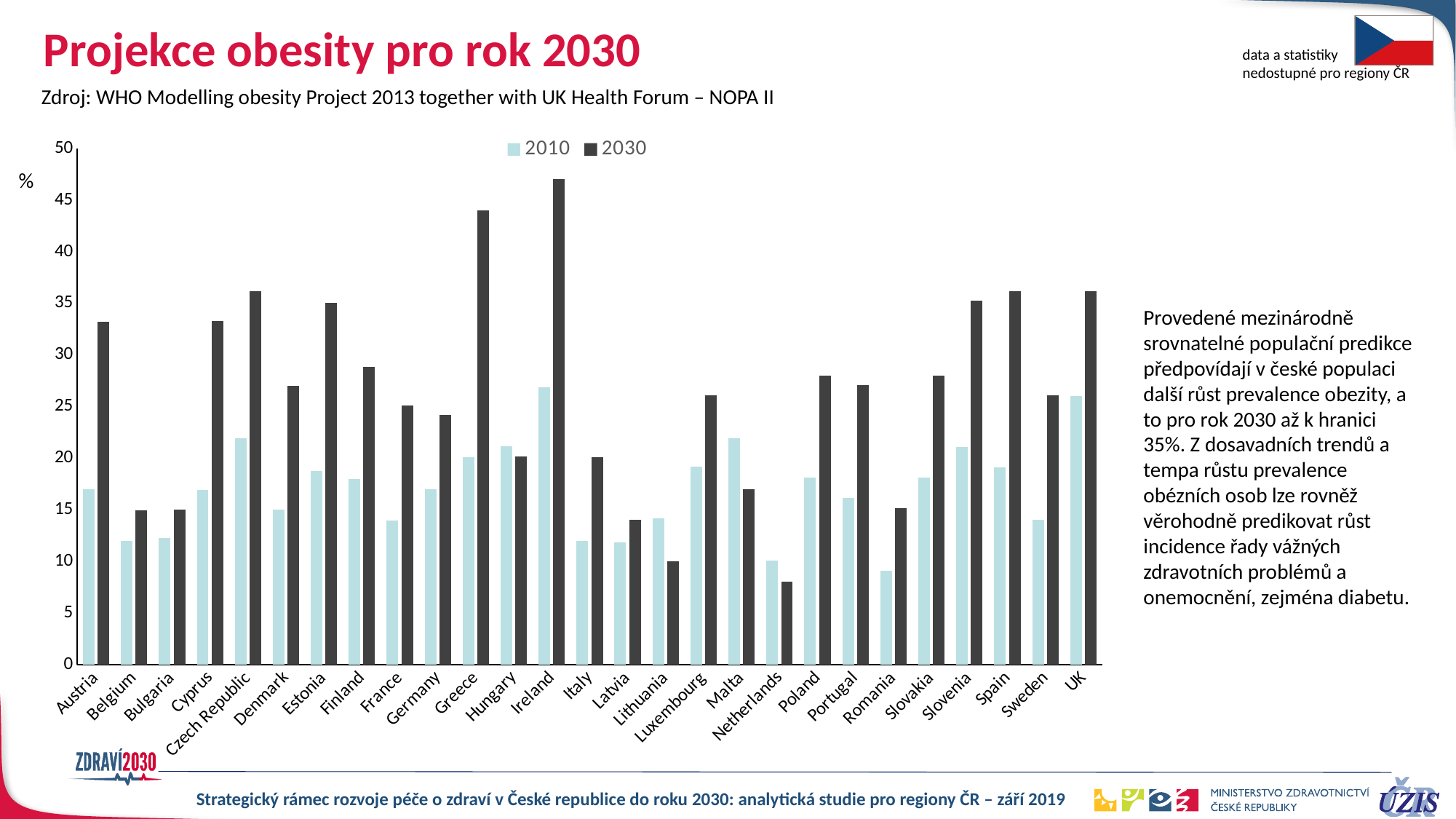
Is the 2010 value for Czech Republic greater or less than 20? greater What kind of chart is shown on the slide? bar chart How many countries are shown on the x axis of the chart? 27 Is the 2030 value for Ireland greater or less than 45? greater How many series does the legend list? 2 What is the title of the slide's chart? Projekce obesity pro rok 2030 For Malta, which is larger: the 2010 value or the 2030 value? 2010 Which country has the highest value for 2030? Ireland Is the 2030 value for Hungary greater or less than 25? less Which country has the lowest value for 2030? Netherlands